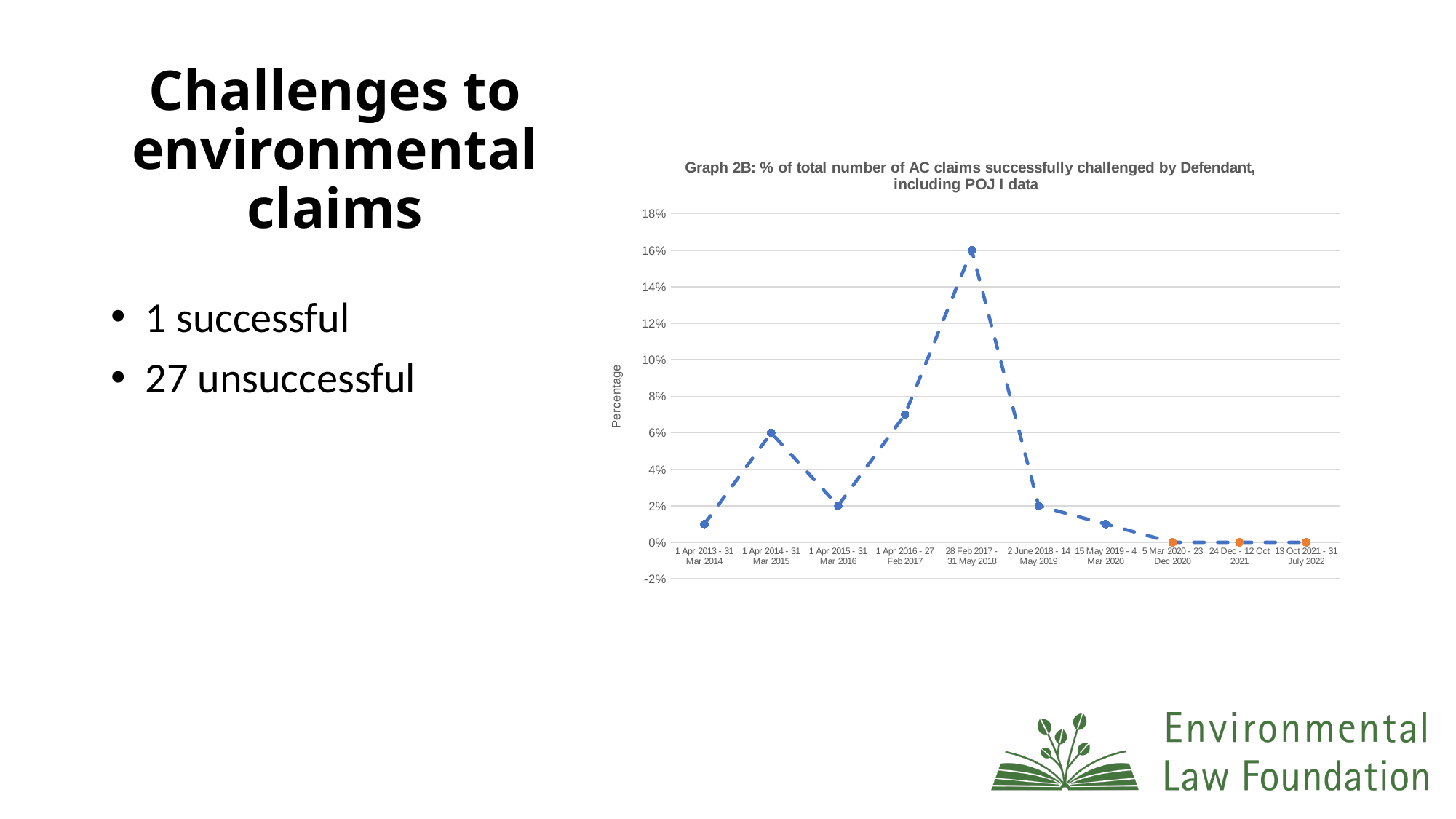
Which period has the highest percentage of AC claims successfully challenged by Defendant? 28 Feb 2017 - 31 May 2018 What type of chart is Graph 2B? line chart Which is larger, the value for 1 Apr 2014 - 31 Mar 2015 or the value for 1 Apr 2015 - 31 Mar 2016? 1 Apr 2014 - 31 Mar 2015 What is the value for the period 1 Apr 2015 - 31 Mar 2016? 2% How many periods on the chart have a value of 0%? 3 What is the value for the period 13 Oct 2021 - 31 July 2022? 0% Do the values rise or fall from the period 28 Feb 2017 - 31 May 2018 to the period 13 Oct 2021 - 31 July 2022? fall What is the value for the period 1 Apr 2014 - 31 Mar 2015? 6% What is the difference between the value for 28 Feb 2017 - 31 May 2018 and the value for 1 Apr 2014 - 31 Mar 2015? 10% What is the value for the period 28 Feb 2017 - 31 May 2018? 16% Is the value for 1 Apr 2016 - 27 Feb 2017 greater or less than 6%? greater How many time periods are plotted on the x axis of Graph 2B? 10